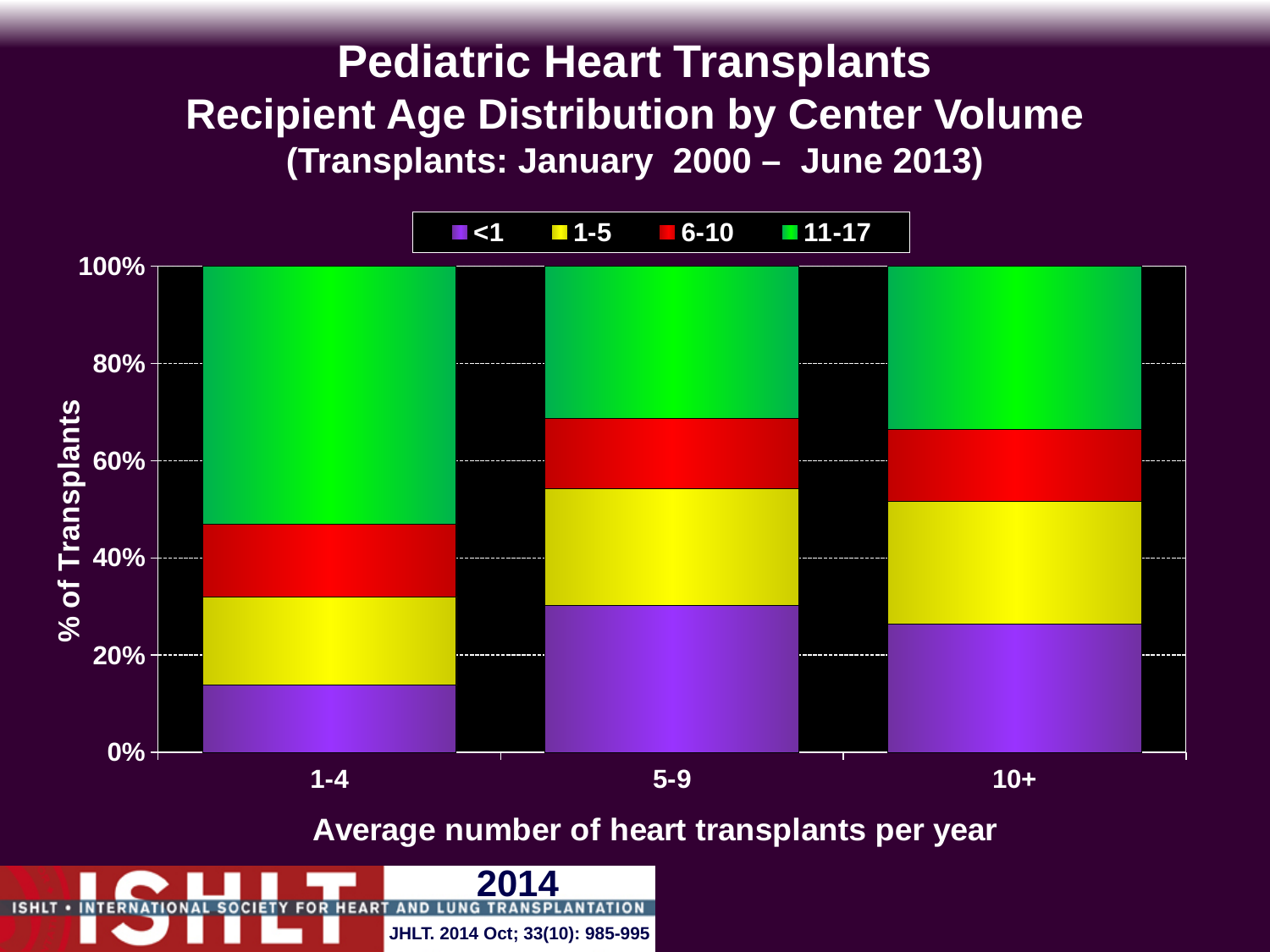
What is the title of the x axis? Average number of heart transplants per year What kind of chart is shown on the slide? Stacked bar chart Which colour represents the 11-17 age group in the legend? Green How many center volume categories are shown on the x axis? 3 Is the share of recipients aged 11-17 at centers with 5-9 transplants per year greater or less than 40%? less Is the share of recipients aged <1 at centers with 5-9 transplants per year greater or less than 20%? greater Which center volume category has the smallest share of recipients aged <1? 1-4 How many age groups does the legend list? 4 Which center volume category has the largest share of recipients aged 11-17? 1-4 Is the share of recipients aged <1 larger at centers with 5-9 or 1-4 transplants per year? 5-9 Is the share of recipients aged 11-17 at centers with 1-4 transplants per year greater or less than 40%? greater